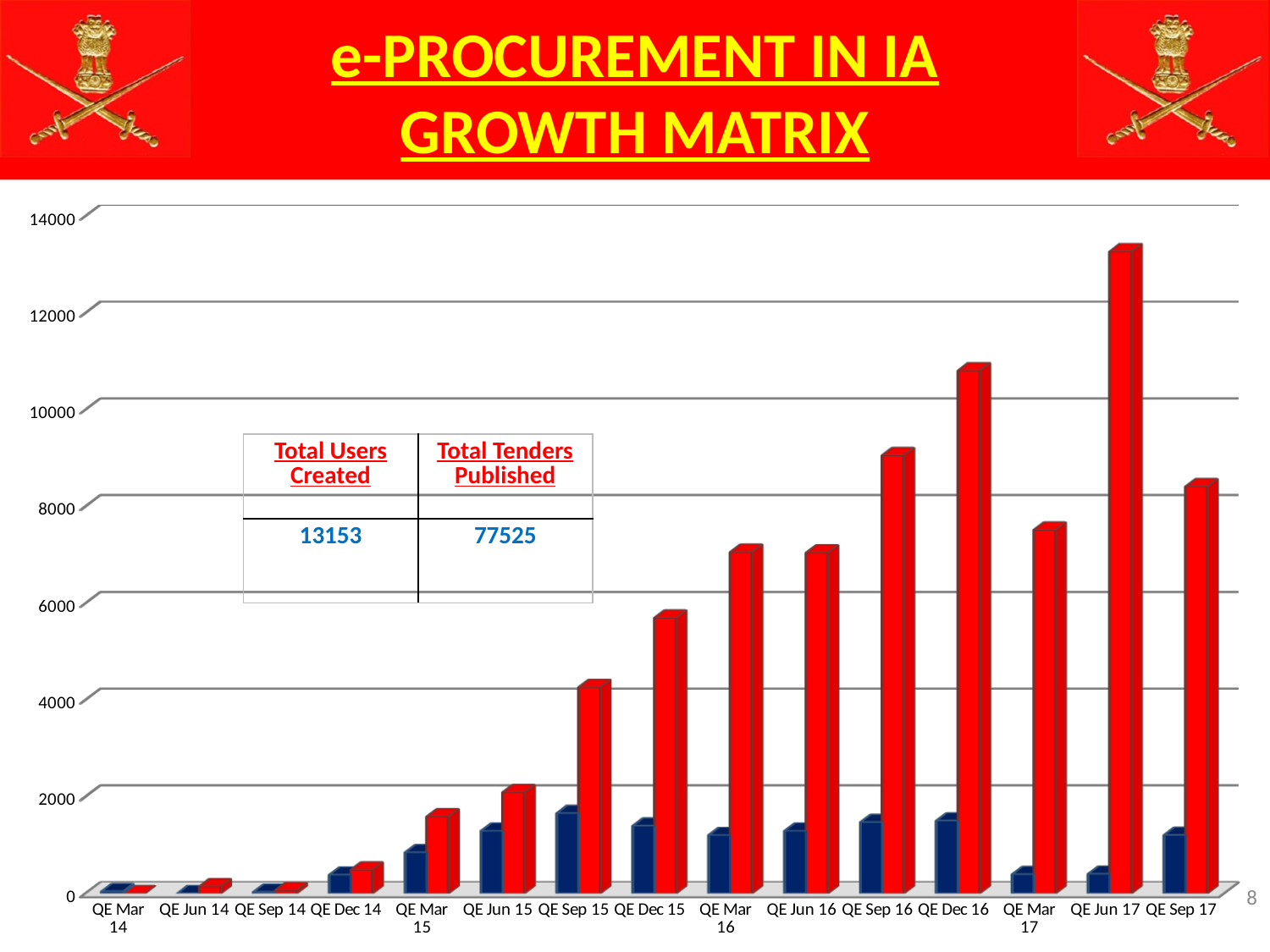
Which has the larger red bar, QE Jun 17 or QE Sep 17? QE Jun 17 Is the blue bar for QE Sep 15 greater or less than 2000? less Which has the larger red bar, QE Sep 16 or QE Dec 16? QE Dec 16 According to the table on the chart, what is the value for Total Tenders Published? 77525 Is the red bar for QE Sep 15 greater or less than 4000? greater Do the red bars generally rise or fall from QE Mar 14 to QE Jun 17? rise Is the red bar for QE Mar 17 greater or less than 8000? less How many quarter categories are shown along the x axis of the chart? 15 Which quarter has the tallest red bar in the chart? QE Jun 17 What kind of chart is shown on the slide? bar chart